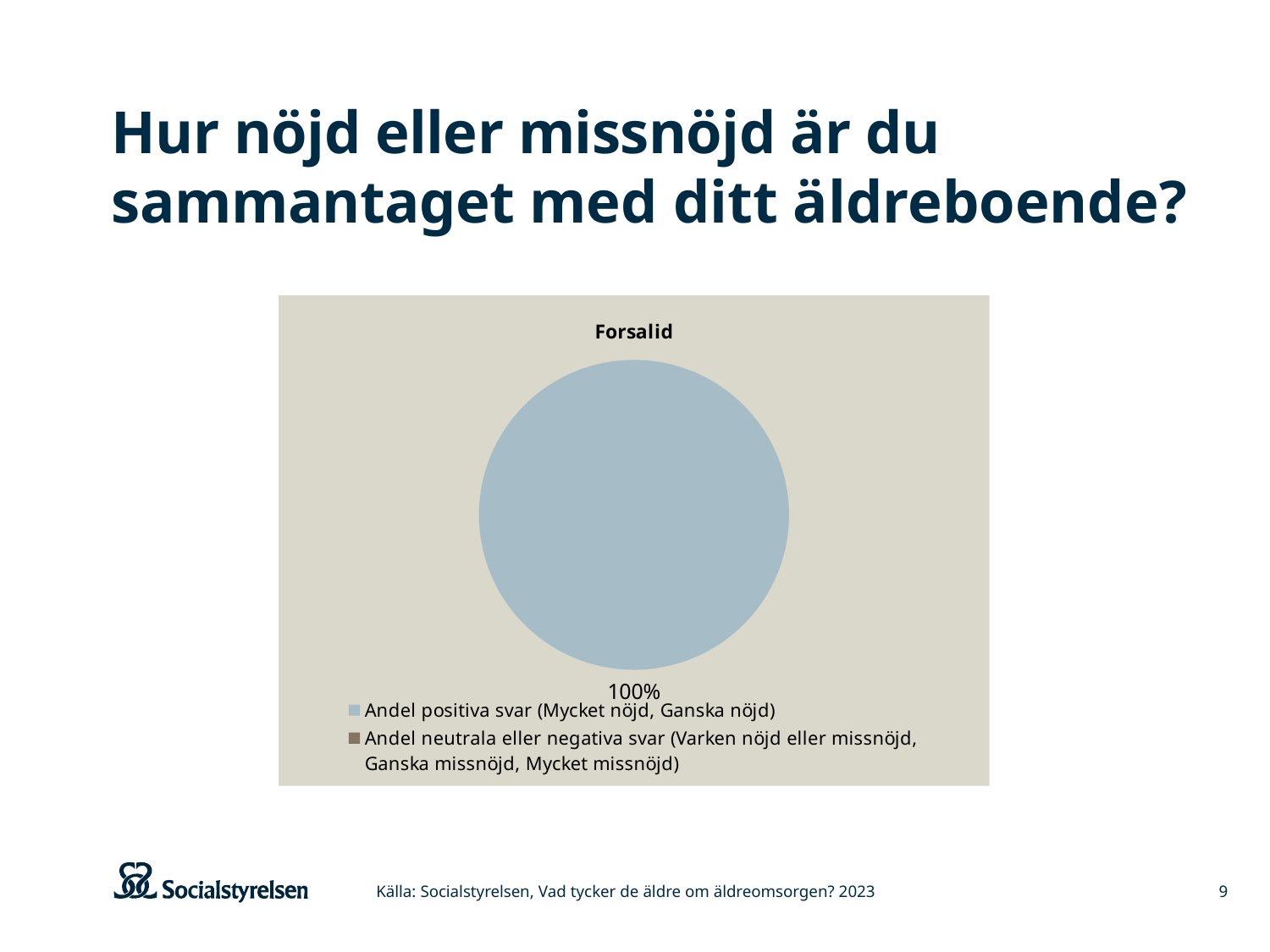
Which legend entry accounts for the largest share of the pie? Andel positiva svar (Mycket nöjd, Ganska nöjd) What colour is the slice for 'Andel positiva svar (Mycket nöjd, Ganska nöjd)'? light blue How many series does the legend list? 2 What is the value shown as a data label on the pie? 100% What is the title of the chart? Forsalid What share of the pie is labelled for 'Andel positiva svar (Mycket nöjd, Ganska nöjd)'? 100% Which is larger: the share for 'Andel positiva svar' or the share for 'Andel neutrala eller negativa svar'? Andel positiva svar What kind of chart is shown on the slide? pie chart How many visible slices does the pie have? 1